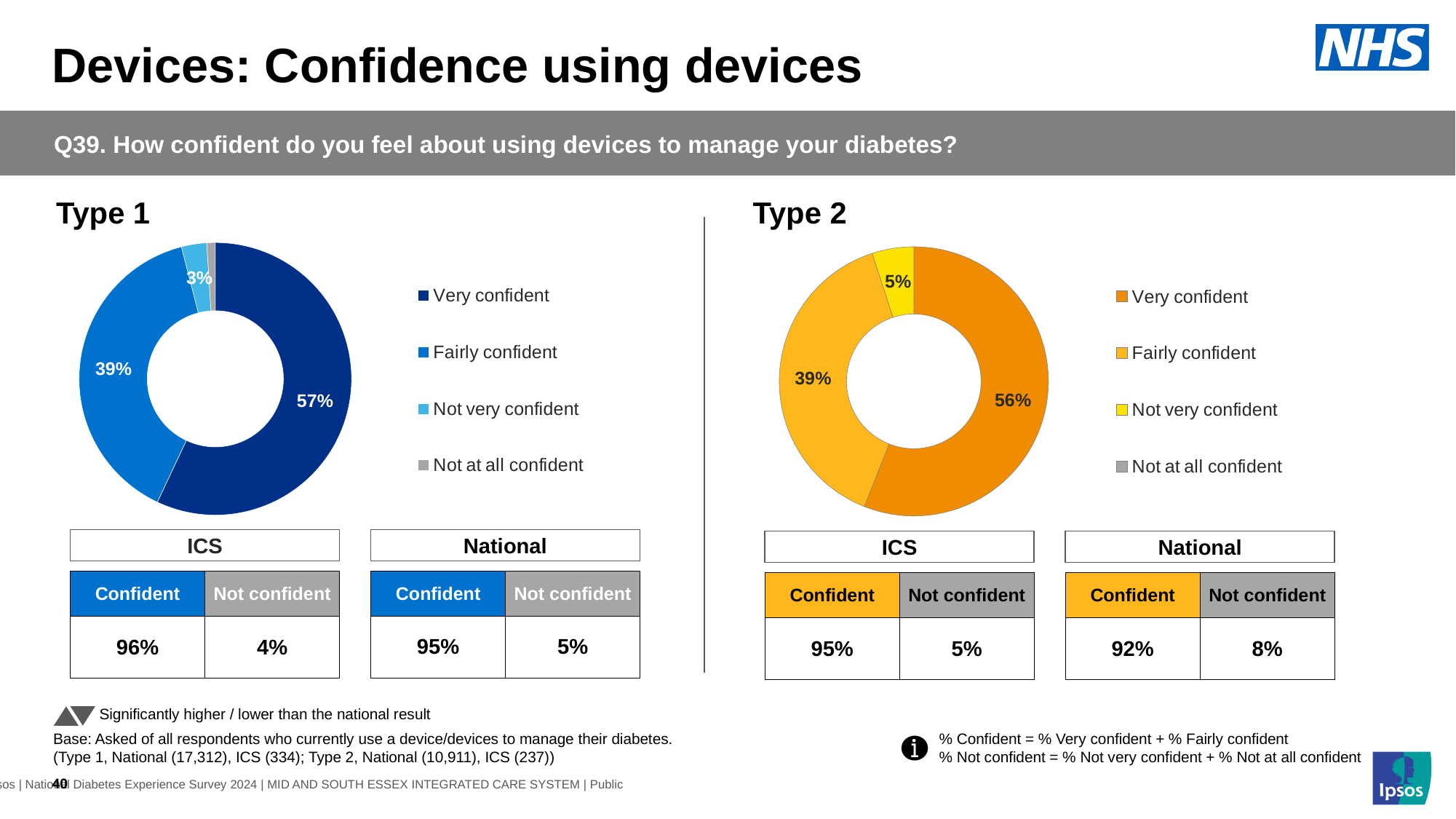
In the Type 1 chart, what percentage of respondents are fairly confident? 39% In the Type 2 chart, which response category has the largest share? Very confident How many response categories does the legend of the Type 1 chart list? 4 In the Type 1 chart, what percentage of respondents are very confident using devices? 57% What kind of chart is used to show the Type 2 results? Pie (donut) chart In the Type 1 chart, which response category has the smallest share? Not at all confident In the Type 1 chart, what percentage of respondents are not very confident? 3% In the Type 1 chart, what is the difference in percentage points between Very confident and Fairly confident? 18 In the Type 2 chart, which is larger: Fairly confident or Not very confident? Fairly confident In the Type 2 chart, what colour represents Very confident? Orange In the Type 2 chart, what percentage of respondents are not very confident? 5% In the Type 2 chart, what percentage of respondents are very confident? 56%